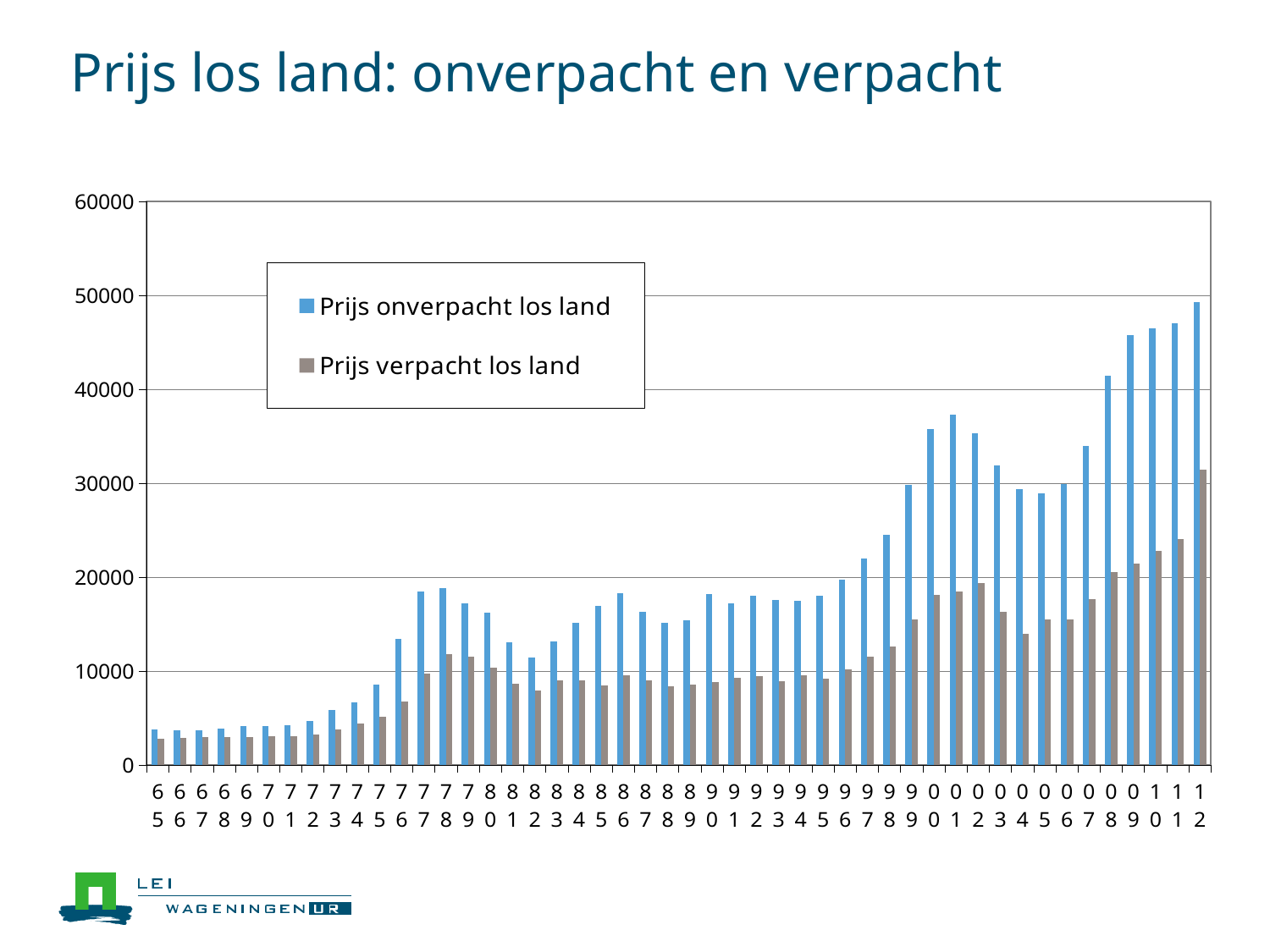
Is the value for Prijs onverpacht los land in year 01 greater or less than 30000? greater Which is larger in year 12: Prijs onverpacht los land or Prijs verpacht los land? Prijs onverpacht los land Does the value for Prijs onverpacht los land rise or fall from year 08 to year 12? rise What is the title of the chart on the slide? Prijs los land: onverpacht en verpacht Is the value for Prijs onverpacht los land in year 65 greater or less than 10000? less Is the value for Prijs verpacht los land in year 01 greater or less than 20000? less In which year is the value for Prijs verpacht los land highest? 12 What kind of chart is shown on the slide? bar chart How many year categories are shown on the x axis? 48 How many series does the legend list? 2 In which year is the value for Prijs onverpacht los land highest? 12